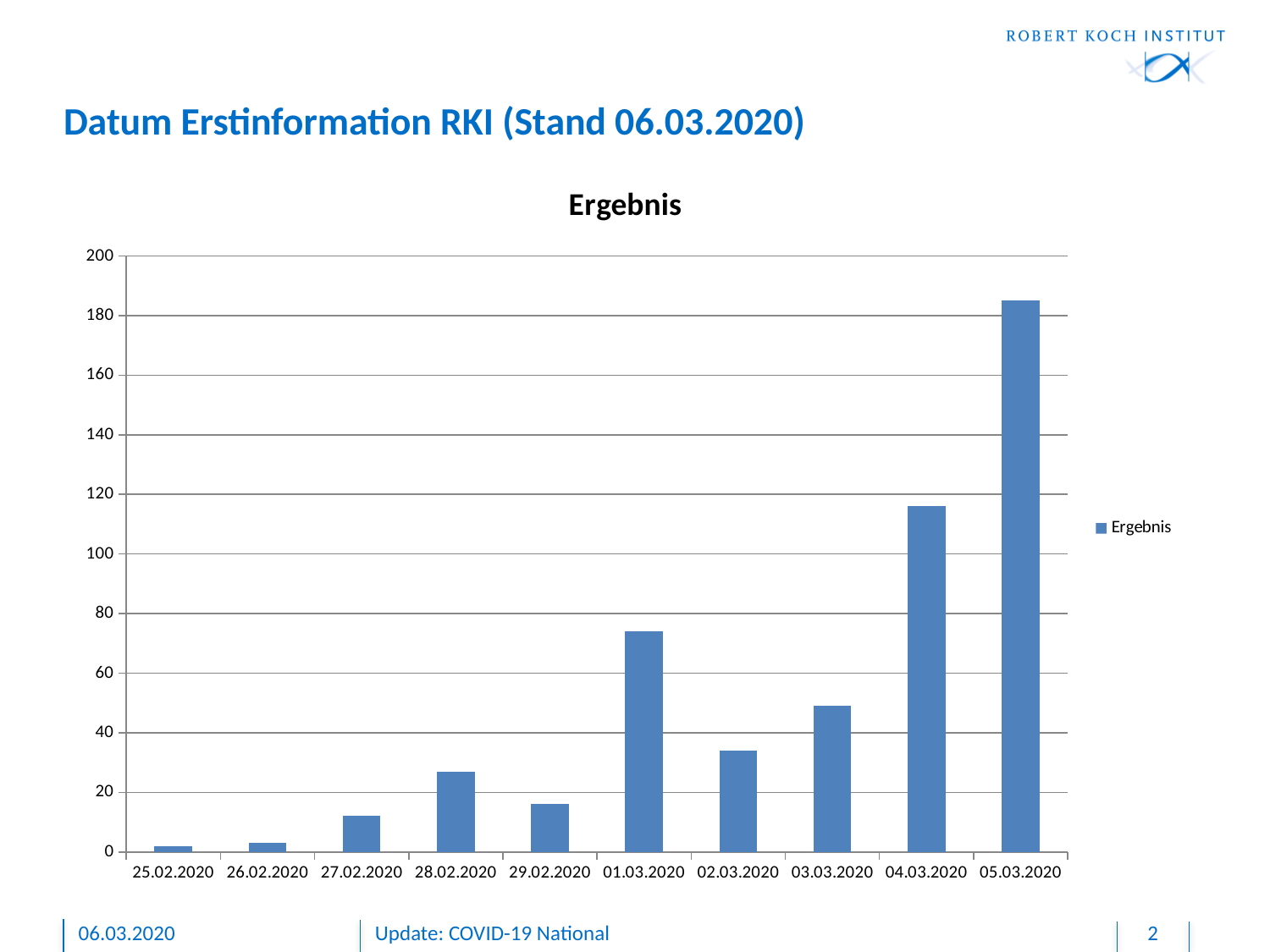
Is the value for 05.03.2020 greater or less than 180? greater Is the value for 29.02.2020 greater or less than 20? less Is the value for 03.03.2020 greater or less than 40? greater Do the values generally rise or fall from 25.02.2020 to 05.03.2020? rise What is the title of the chart? Ergebnis Which date has the highest value in the chart? 05.03.2020 How many dates are shown on the x axis of the chart? 10 How many series does the legend list? 1 Which has the larger value, 01.03.2020 or 02.03.2020? 01.03.2020 What kind of chart is shown on the slide? bar chart